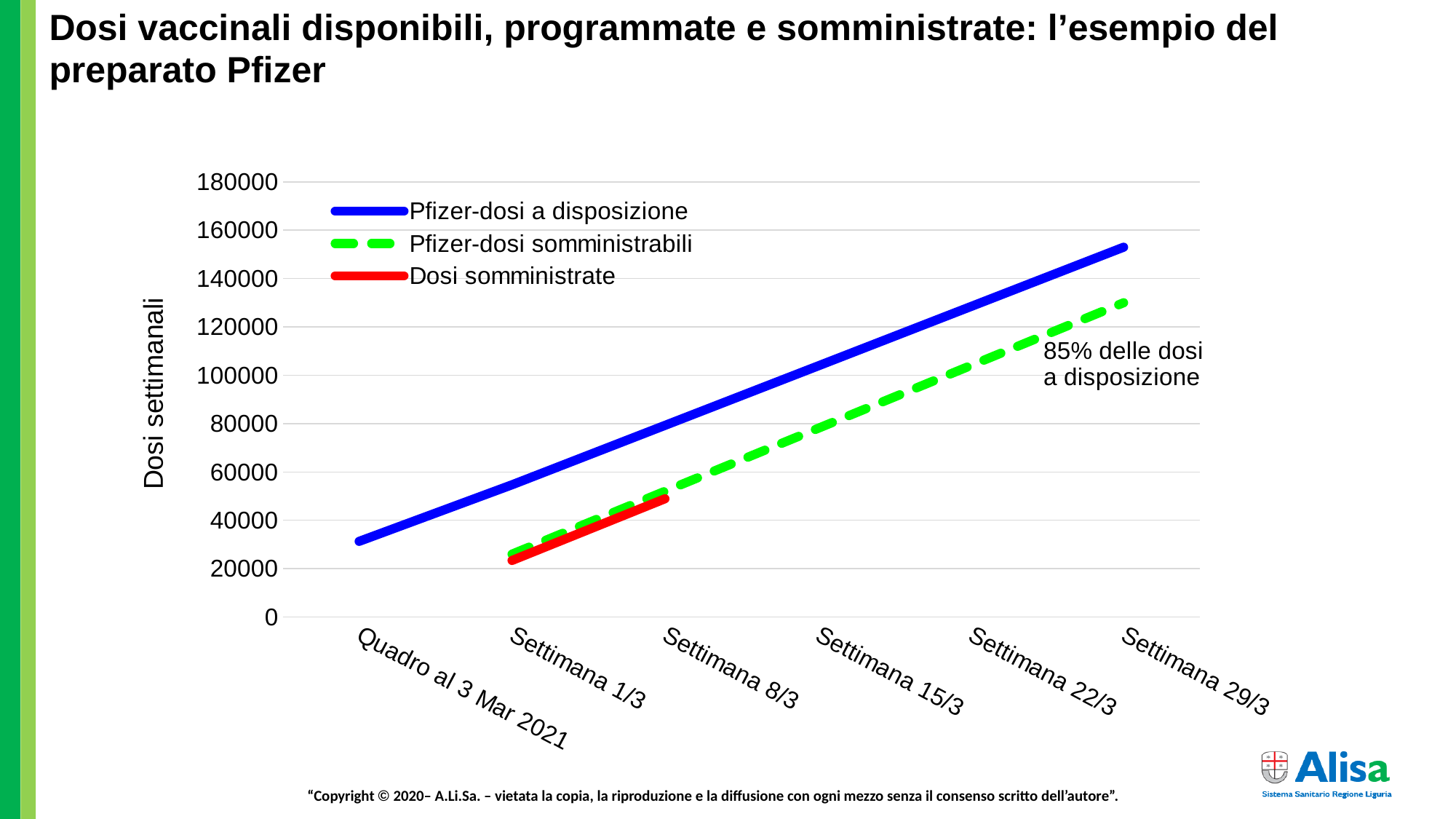
Is the value for Pfizer-dosi a disposizione at Settimana 22/3 greater or less than 120000? greater What colour is the Dosi somministrate line? red What kind of chart is shown on the slide? line chart Is the value for Pfizer-dosi somministrabili at Settimana 29/3 greater or less than 120000? greater How many categories are shown on the x axis? 6 At Settimana 29/3, which series is higher: Pfizer-dosi a disposizione or Pfizer-dosi somministrabili? Pfizer-dosi a disposizione Is the value for Dosi somministrate at Settimana 8/3 greater or less than 40000? greater How many series does the legend list? 3 What is the label on the y axis? Dosi settimanali Does the Pfizer-dosi a disposizione series rise or fall from Quadro al 3 Mar 2021 to Settimana 29/3? rise